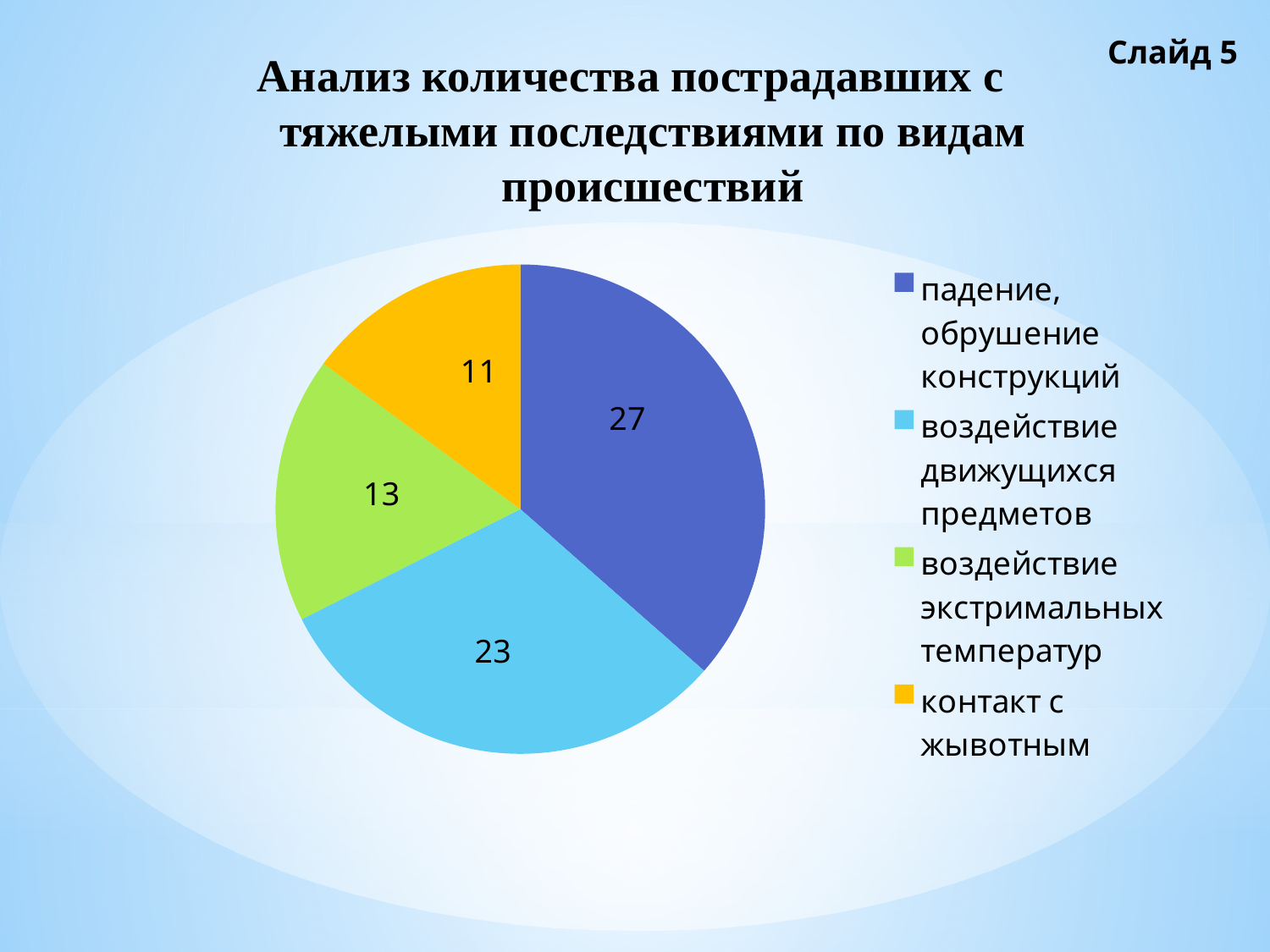
What is the value for "воздействие экстримальных температур"? 13 Which category has the smallest slice of the pie? контакт с жывотным What is the difference between the values for "падение, обрушение конструкций" and "воздействие движущихся предметов"? 4 What is the total of all slices in the pie chart? 74 How many categories does the pie chart have? 4 What colour is the slice for "контакт с животным"? yellow What is the value for "воздействие движущихся предметов"? 23 What is the value for "падение, обрушение конструкций"? 27 Which category has the largest slice of the pie? падение, обрушение конструкций What type of chart is shown on the slide? pie chart What is the value for "контакт с животным"? 11 Which is larger: the value for "воздействие экстримальных температур" or the value for "контакт с животным"? воздействие экстримальных температур